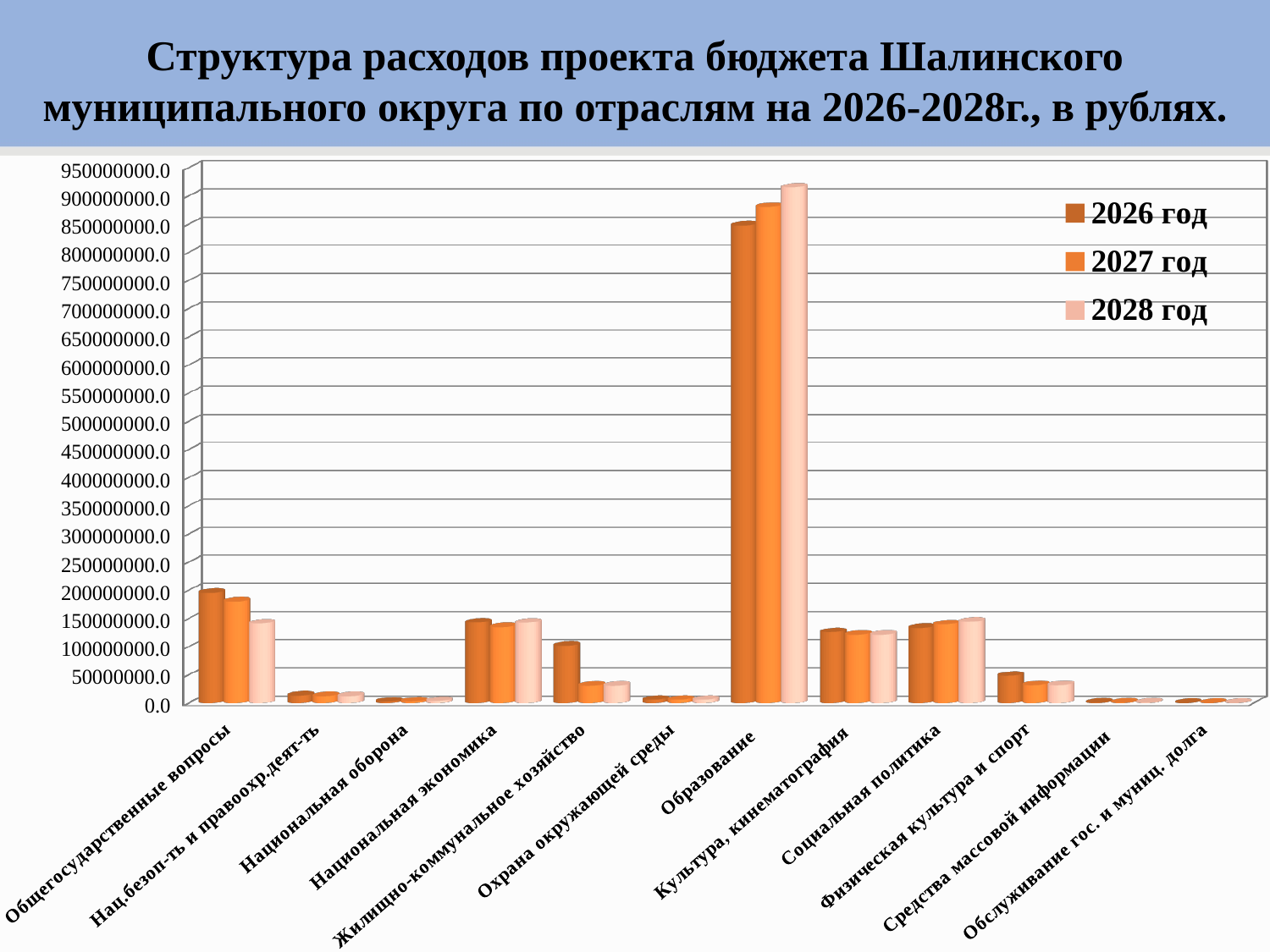
Do the values for Образование rise or fall from 2026 год to 2028 год? rise Is the value for Образование in 2028 год greater or less than 850000000.0? greater How many series does the legend list? 3 What kind of chart is shown on the slide? Bar chart What are the three series listed in the legend? 2026 год, 2027 год, 2028 год Is the value for Образование in 2026 год greater or less than 800000000.0? greater Which is larger for Образование: the value for 2026 год or for 2028 год? 2028 год Is the value for Жилищно-коммунальное хозяйство in 2027 год greater or less than 50000000.0? less How many categories (sectors) are shown on the x axis of the chart? 12 Which category has the highest expenditure in the chart? Образование Which is larger for Общегосударственные вопросы: the value for 2026 год or for 2028 год? 2026 год